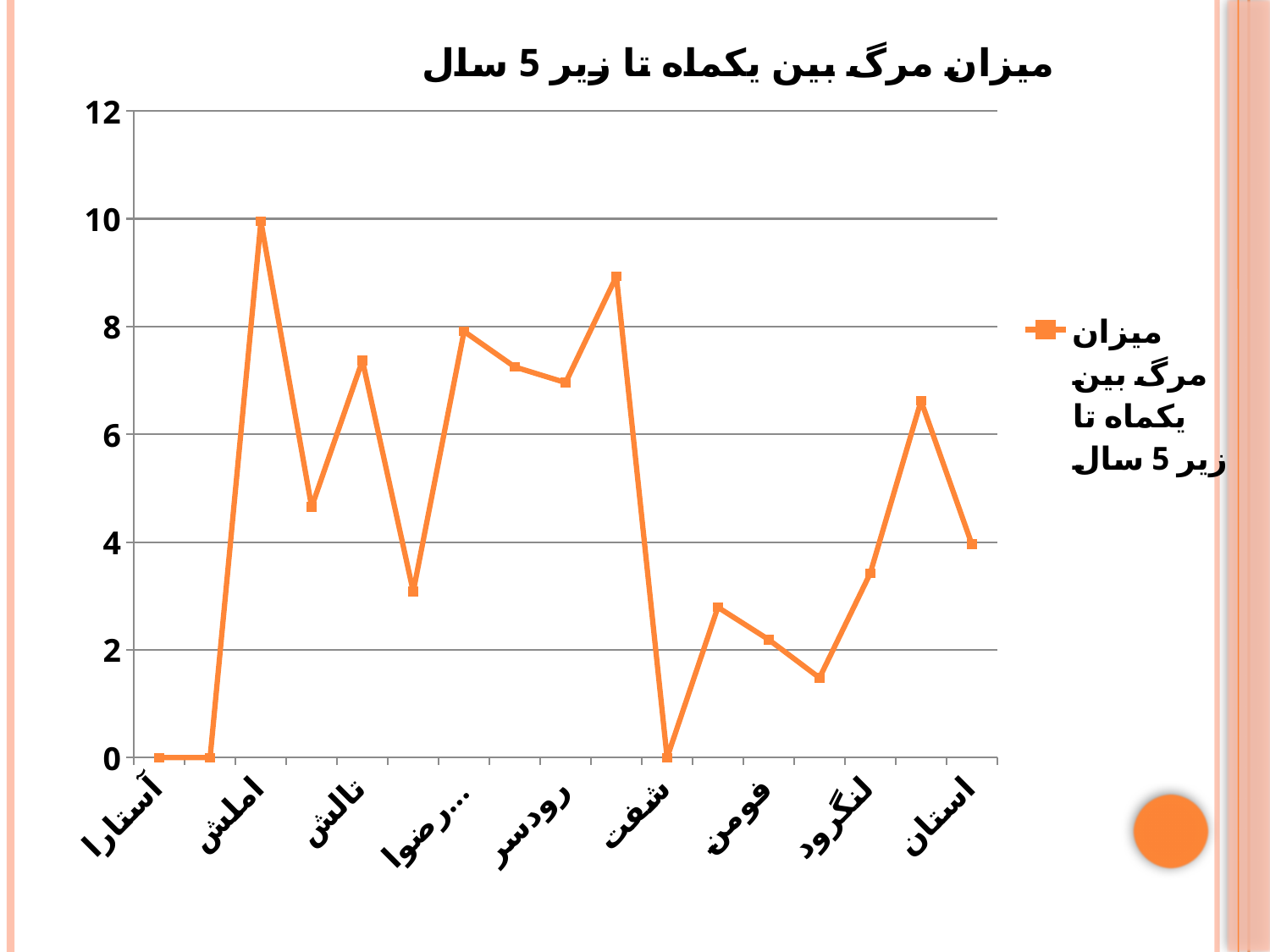
Which is larger, the value for املش or the value for تالش? املش Is the value for فومن greater or less than 4? less Which labelled category has the highest value? املش Which is larger, the value for لنگرود or the value for فومن? لنگرود What is the value for آستارا? 0 Is the value for تالش greater or less than 6? greater What colour is the plotted line? orange What kind of chart is shown on the slide? line chart What is the value for شفت? 0 Is the value for رودسر greater or less than 6? greater What is the title of the chart? میزان مرگ بین یکماه تا زیر 5 سال How many series does the legend list? 1